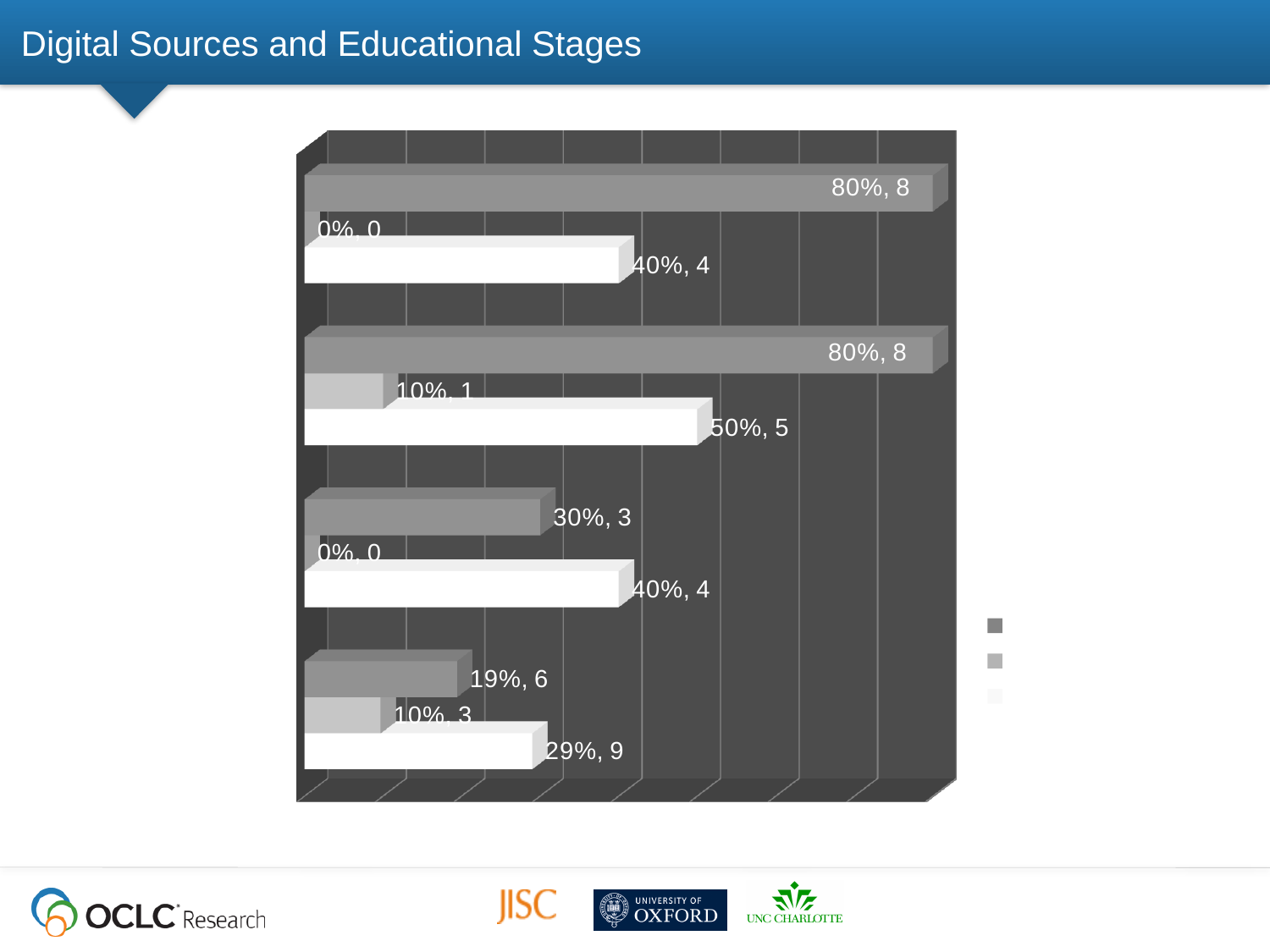
In the third group of bars from the top, what is the difference in percentage points between the white bar (40%) and the dark grey bar (30%)? 10 percentage points What is the title of the slide? Digital Sources and Educational Stages What is the data label on the white bar in the second group of bars from the top? 50%, 5 Which group of bars has the longest white bar? the second group from the top What is the data label on the light grey bar in the bottom group of bars? 10%, 3 What is the data label on the dark grey bar in the top group of bars? 80%, 8 What is the data label on the dark grey bar in the third group of bars from the top? 30%, 3 How many groups of bars are plotted in the chart? 4 What is the data label on the white bar in the bottom group of bars? 29%, 9 In the bottom group of bars, which is larger: the dark grey bar or the white bar? the white bar How many entries does the legend on the right of the chart list? 3 What kind of chart is shown on the slide? bar chart